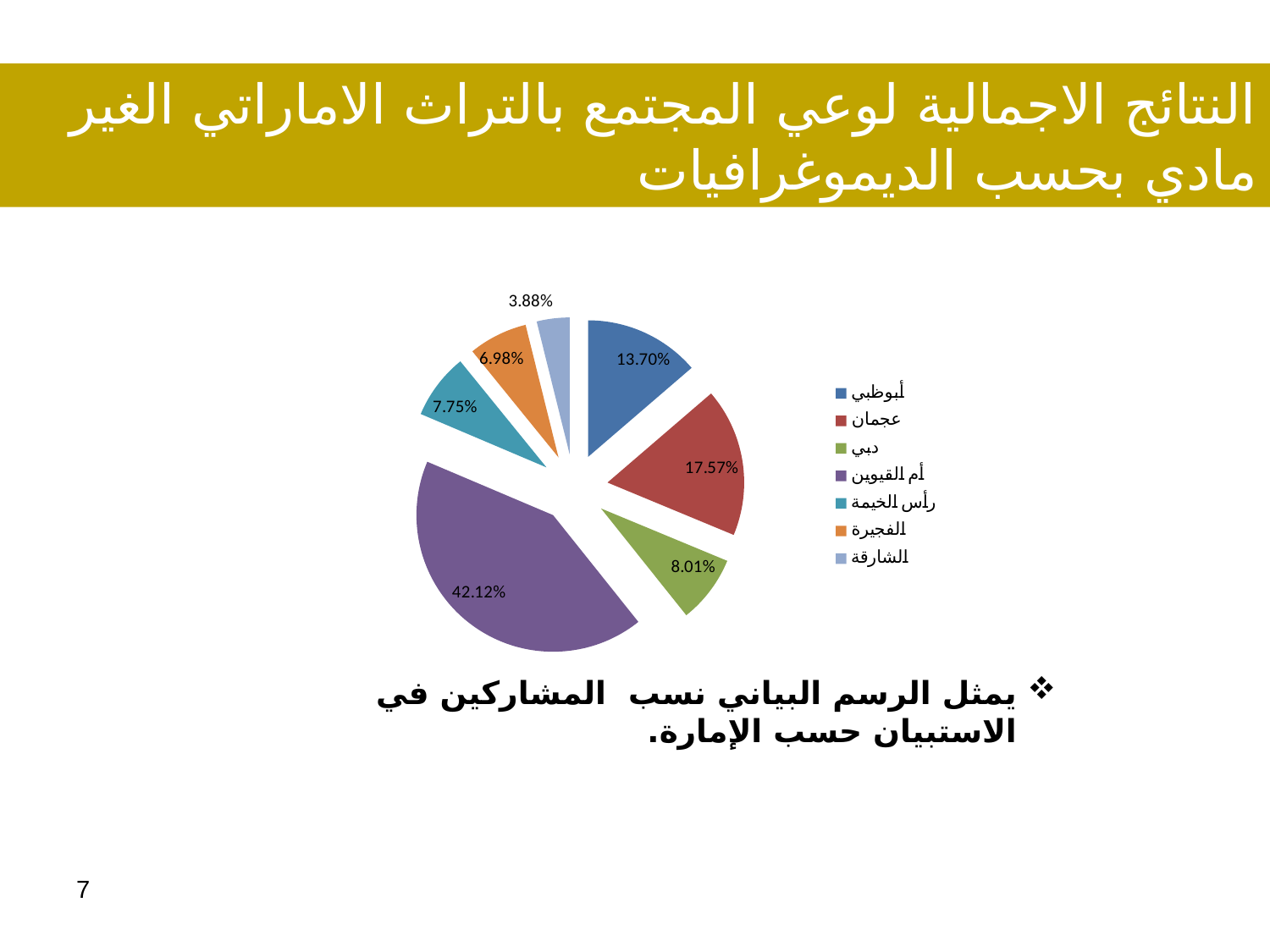
Which is larger, the slice for دبي or the slice for الفجيرة? دبي What is the difference between the values for عجمان and أبوظبي? 3.87% What is the combined share of رأس الخيمة and الفجيرة? 14.73% What is the value shown for الشارقة in the pie chart? 3.88% How many slices does the pie chart have? 7 What colour is the slice for أم القيوين? Purple Which category has the smallest slice in the pie chart? الشارقة Which category has the largest slice in the pie chart? أم القيوين What type of chart is shown on the slide? Pie chart What is the value shown for عجمان in the pie chart? 17.57% What percentage of the pie chart does أم القيوين represent? 42.12% What is the value shown for أبوظبي in the pie chart? 13.70%